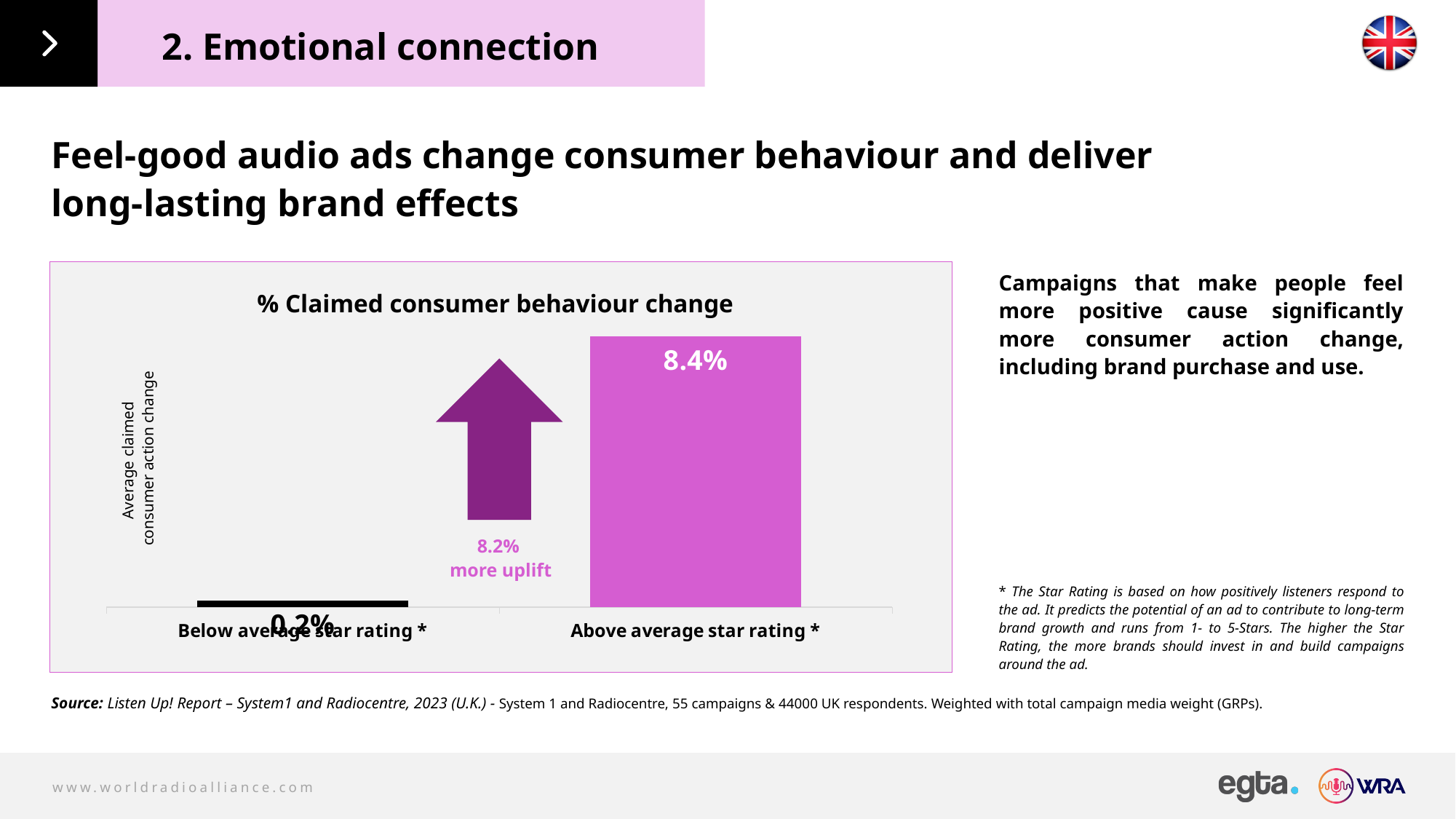
How many categories are shown in the '% Claimed consumer behaviour change' chart? 2 What is the title of the chart on the slide? % Claimed consumer behaviour change What is the value for 'Below average star rating *' in the '% Claimed consumer behaviour change' chart? 0.2% What is the difference between the values for 'Above average star rating *' and 'Below average star rating *'? 8.2% What uplift does the arrow annotation in the chart indicate? 8.2% more uplift What is the label on the vertical axis of the chart? Average claimed consumer action change What is the value for 'Above average star rating *' in the '% Claimed consumer behaviour change' chart? 8.4% Which is larger: the value for 'Above average star rating *' or 'Below average star rating *'? Above average star rating * Which category has the highest value in the '% Claimed consumer behaviour change' chart? Above average star rating * What kind of chart is shown on the slide? Bar chart Which category has the lowest value in the '% Claimed consumer behaviour change' chart? Below average star rating *